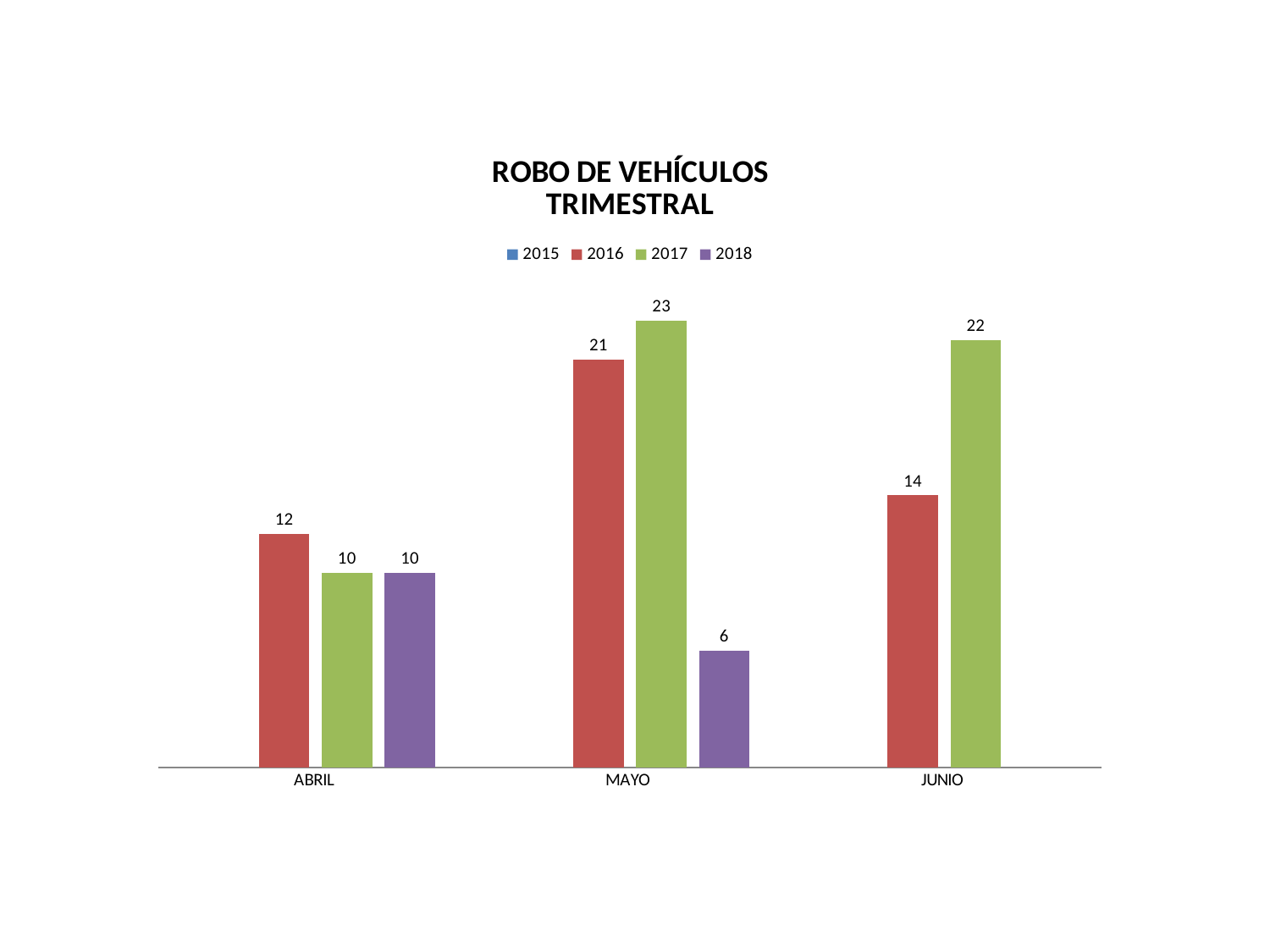
What is the value for 2016 in JUNIO? 14 Which month has the lowest value for 2017? ABRIL How many months are shown on the x axis? 3 What is the title of the chart? ROBO DE VEHÍCULOS TRIMESTRAL What is the difference between the 2017 and 2016 values in JUNIO? 8 What is the value for 2017 in MAYO? 23 What is the value for 2016 in ABRIL? 12 How many series does the legend list? 4 Which is larger in MAYO, the value for 2016 or the value for 2017? 2017 Which month has the highest value for 2016? MAYO What is the value for 2018 in MAYO? 6 What kind of chart is shown? bar chart